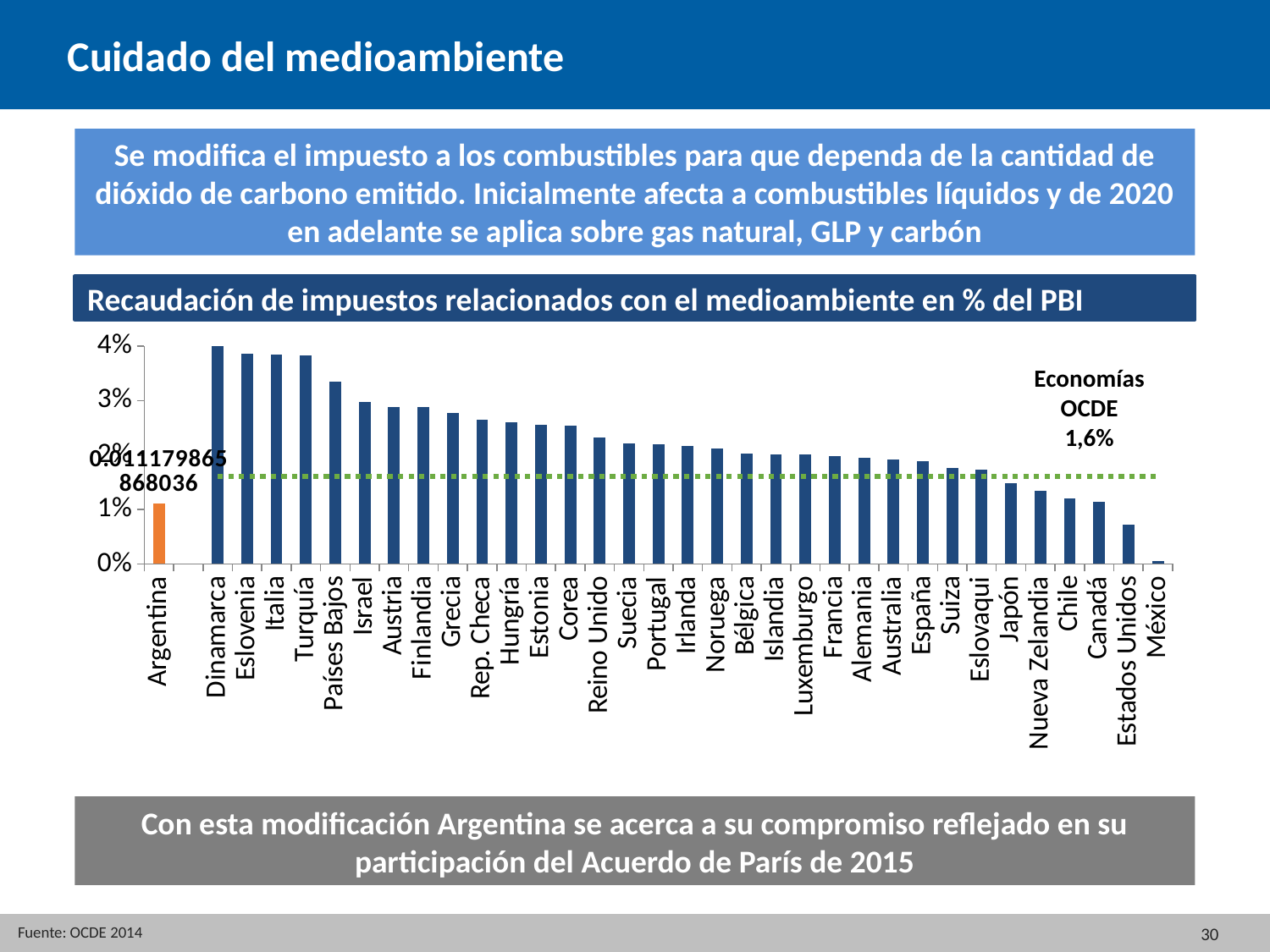
Which country has the highest value in the chart? Dinamarca Which has a larger value, Italia or Chile? Italia Which country has the lowest value in the chart? México Do the values rise or fall along the x axis from Dinamarca to México? fall What value is given for the 'Economías OCDE' reference line in the chart? 1,6% Is the value for Argentina greater or less than 2%? less What kind of chart is shown on the slide? bar chart Is the value for Estados Unidos greater or less than 1%? less How many countries are shown on the x axis of the chart? 34 Is the value for Israel greater or less than 2%? greater Which has a larger value, Argentina or Dinamarca? Dinamarca